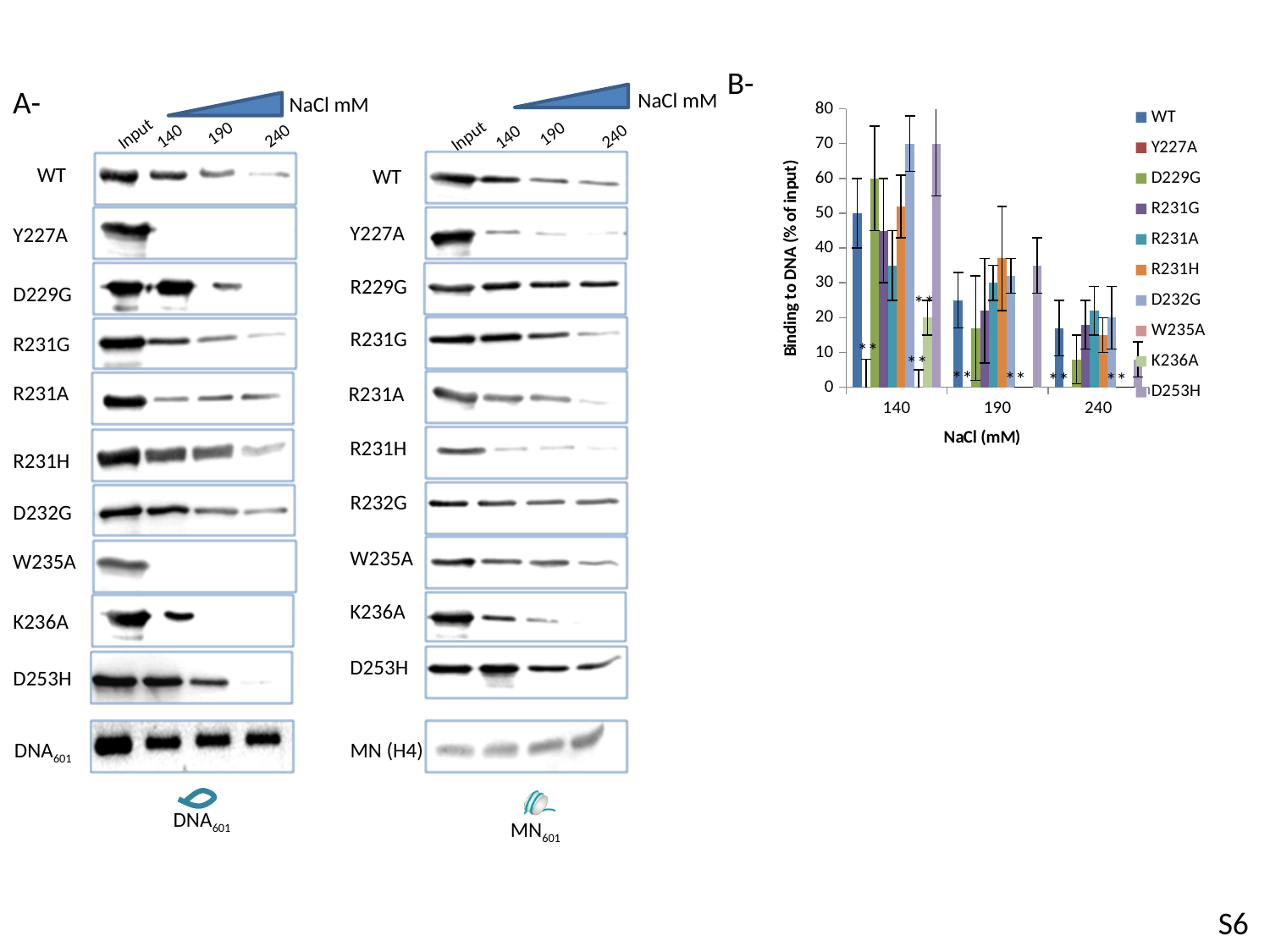
What is the y-axis title of the chart in panel B? Binding to DNA (% of input) How many NaCl concentration categories are shown on the x axis of the chart in panel B? 3 In the chart in panel B, which is larger at 140 mM NaCl: the value for D232G or the value for K236A? D232G In the chart in panel B, do the WT values rise or fall as NaCl concentration increases from 140 to 240 mM? fall How many series does the legend of the chart in panel B list? 10 What kind of chart is shown in panel B? bar chart What is the x-axis title of the chart in panel B? NaCl (mM) In the chart in panel B, is the value for WT at 140 mM NaCl greater or less than 40? greater In the chart in panel B, is the value for R231H at 190 mM NaCl greater or less than 30? greater In the chart in panel B, is the value for K236A at 140 mM NaCl greater or less than 30? less